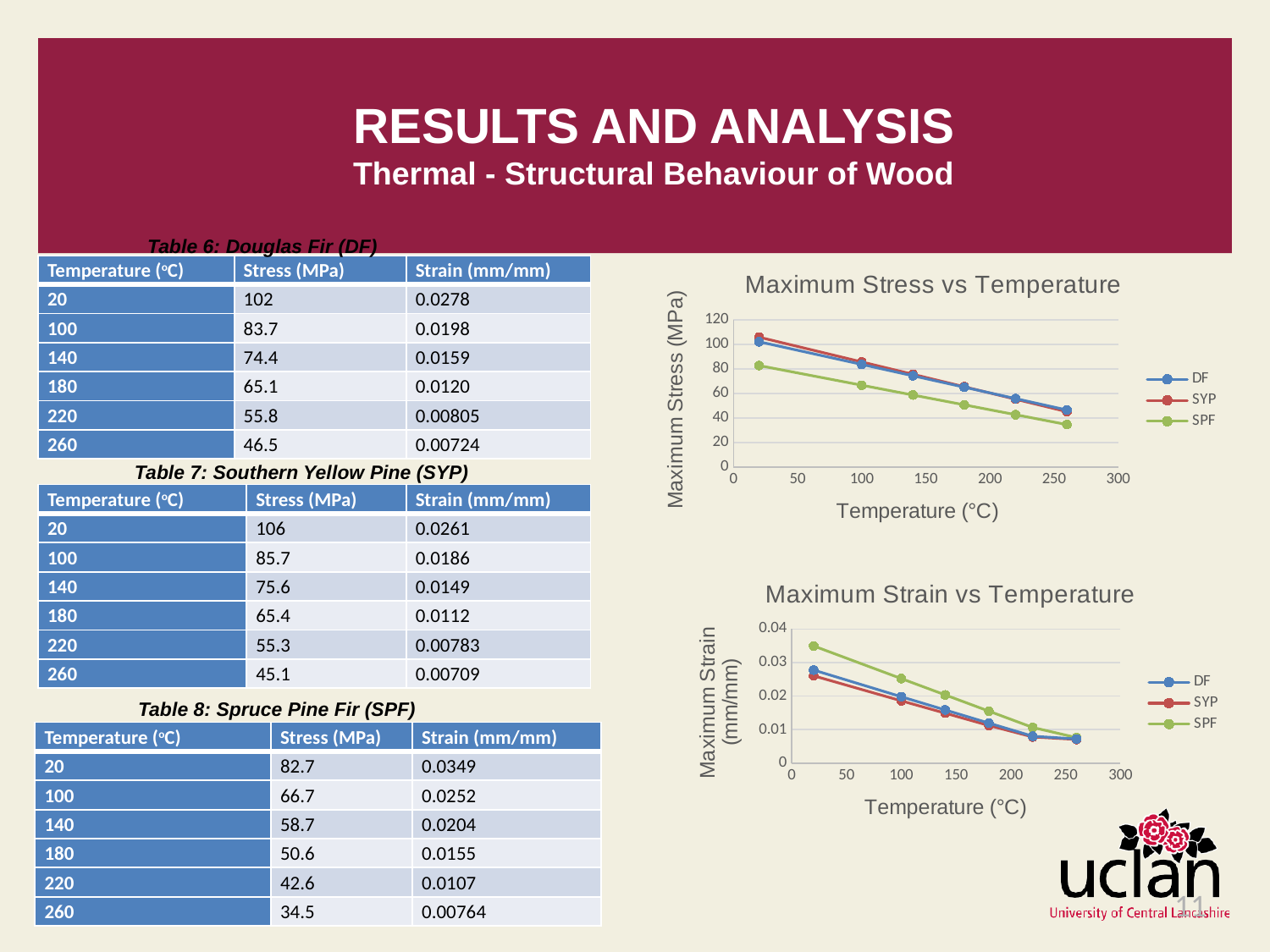
In the "Maximum Strain vs Temperature" chart, which series has the highest strain at 100°C? SPF What kind of chart is the "Maximum Stress vs Temperature" chart? line chart In the "Maximum Stress vs Temperature" chart, which series has the larger value at 20°C, DF or SPF? DF In the "Maximum Strain vs Temperature" chart, do the values rise or fall as temperature increases? fall How many series does the legend of the "Maximum Stress vs Temperature" chart list? 3 How many data points does each series have in the "Maximum Strain vs Temperature" chart? 6 In the "Maximum Stress vs Temperature" chart, is the DF value at 260°C greater or less than 60? less In the "Maximum Stress vs Temperature" chart, which series has the lowest stress values across the temperature range? SPF In the "Maximum Strain vs Temperature" chart, is the SPF value at 20°C greater or less than 0.03? greater In the "Maximum Stress vs Temperature" chart, do the values rise or fall as temperature increases? fall What kind of chart is the "Maximum Strain vs Temperature" chart? line chart In the "Maximum Stress vs Temperature" chart, is the SPF value at 20°C greater or less than 100? less